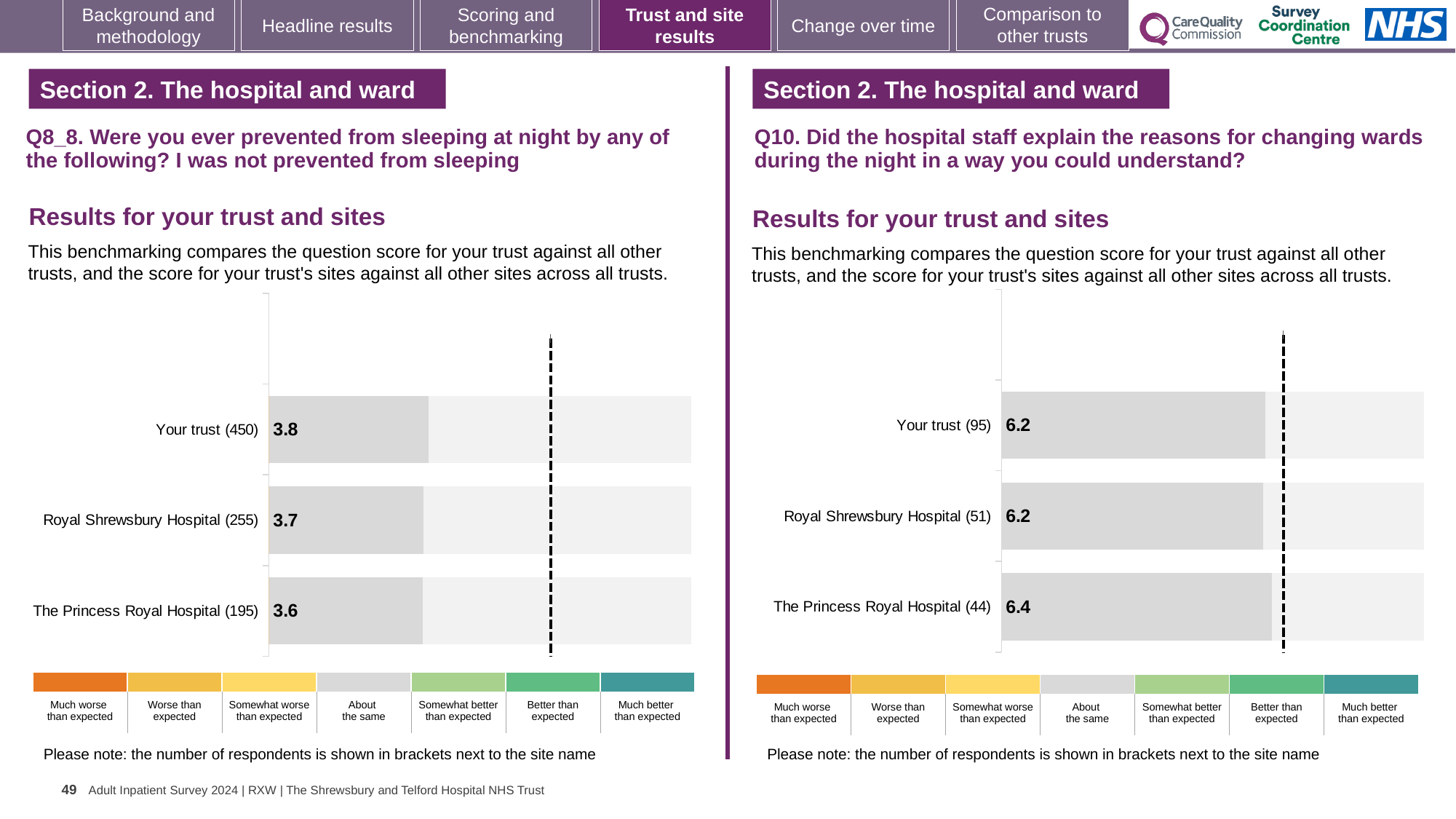
In the right chart (Q10), what is the score for The Princess Royal Hospital (44)? 6.4 In the right chart (Q10), what is the score for Royal Shrewsbury Hospital (51)? 6.2 In the left chart (Q8_8), which site or trust has the highest score? Your trust (450) In the right chart (Q10), what is the difference between the scores for The Princess Royal Hospital (44) and Your trust (95)? 0.2 How many respondents are shown in brackets for Your trust in the right chart (Q10)? 95 In the right chart (Q10), which site or trust has the highest score? The Princess Royal Hospital (44) In the left chart (Q8_8), which has the larger score: Royal Shrewsbury Hospital (255) or The Princess Royal Hospital (195)? Royal Shrewsbury Hospital (255) In the left chart (Q8_8), what is the score for The Princess Royal Hospital (195)? 3.6 In the left chart (Q8_8), what is the difference between the scores for Your trust (450) and The Princess Royal Hospital (195)? 0.2 How many bars are plotted in the right chart (Q10)? 3 In the left chart (Q8_8), what is the score for Your trust (450)? 3.8 What type of chart is used on the left side of the slide (Q8_8)? Bar chart